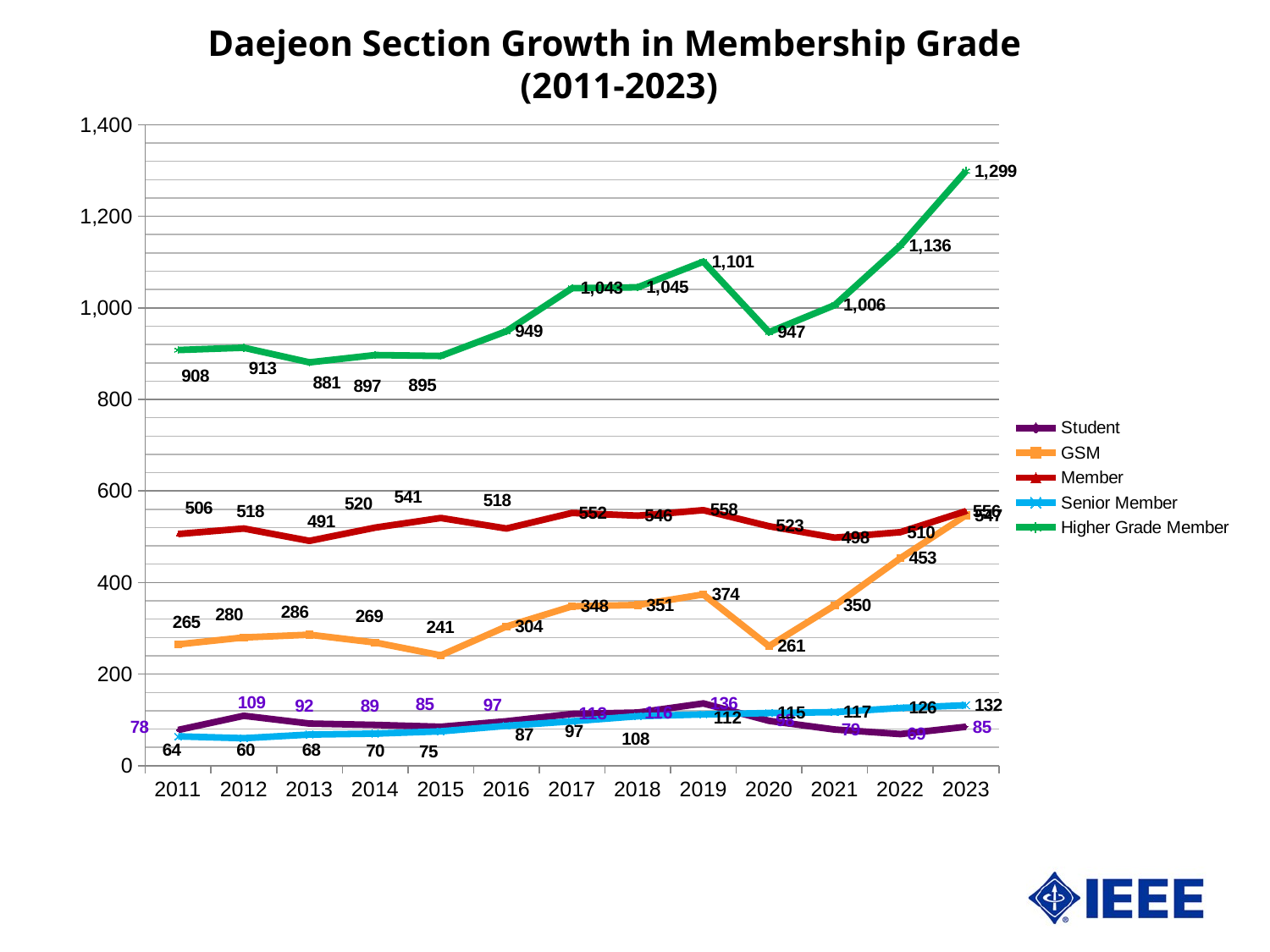
What is the GSM value for 2020? 261 What is the Senior Member value for 2023? 132 How many years are plotted along the x axis? 13 How many series does the legend list? 5 What is the Higher Grade Member value for 2023? 1,299 Which year has the larger Member value, 2019 or 2021? 2019 What kind of chart is shown on the slide? line chart What is the difference between the GSM values for 2022 and 2021? 103 By how much did the Higher Grade Member value increase from 2022 to 2023? 163 In which year is the Higher Grade Member value lowest? 2013 Does the Senior Member series generally rise or fall from 2011 to 2023? rise In which year is the Higher Grade Member value highest? 2023